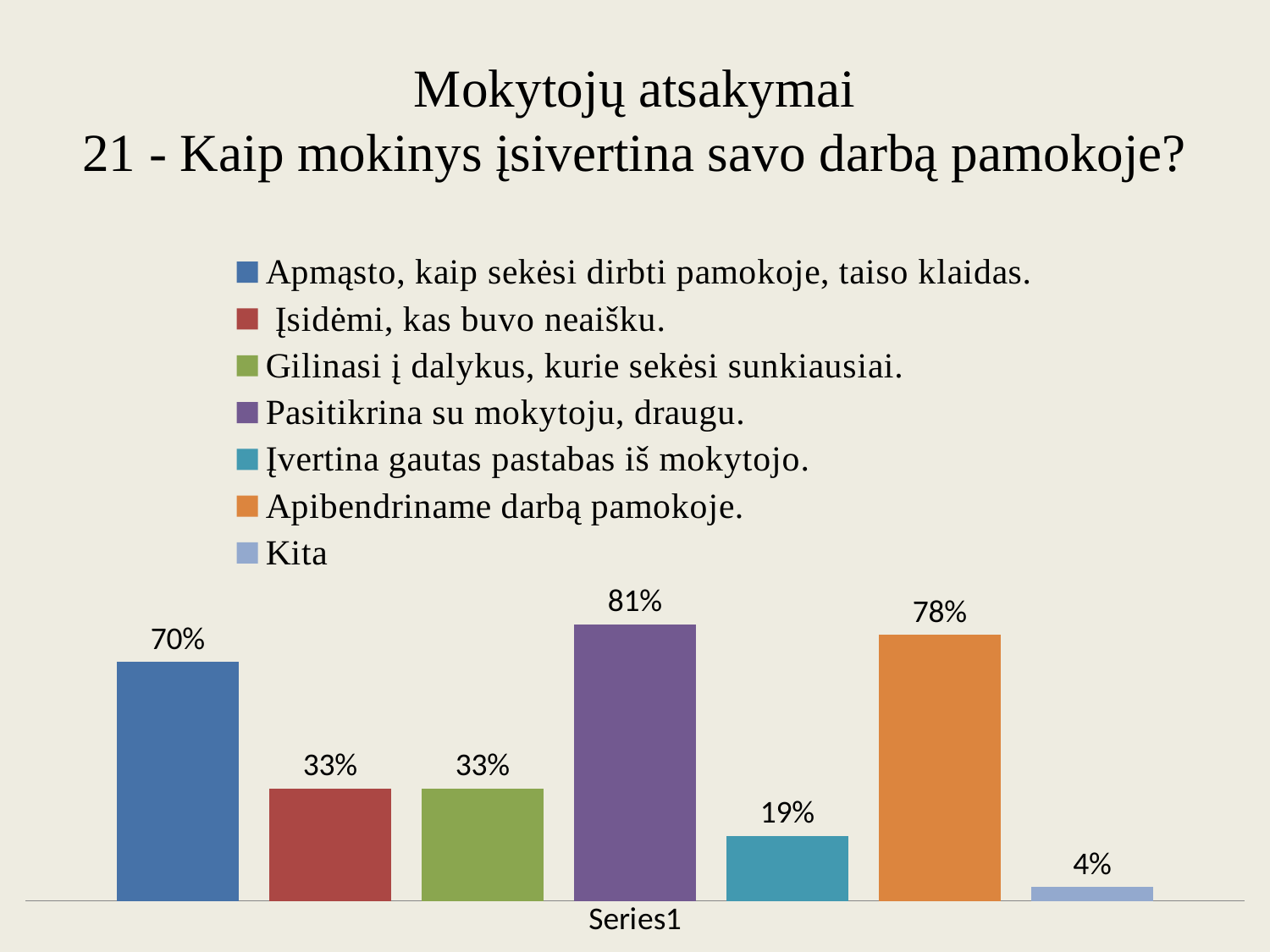
Which is larger, the value for "Apibendriname darbą pamokoje." or the value for "Apmąsto, kaip sekėsi dirbti pamokoje, taiso klaidas."? Apibendriname darbą pamokoje. What is the value for "Kita"? 4% Which legend entry has the highest value? Pasitikrina su mokytoju, draugu. What is the value for "Įvertina gautas pastabas iš mokytojo."? 19% How many bars are plotted in the chart? 7 What is the difference between the values for "Apmąsto, kaip sekėsi dirbti pamokoje, taiso klaidas." and "Įsidėmi, kas buvo neaišku."? 37% What is the difference between the values for "Pasitikrina su mokytoju, draugu." and "Apibendriname darbą pamokoje."? 3% What is the value for "Apmąsto, kaip sekėsi dirbti pamokoje, taiso klaidas."? 70% What is the value for "Pasitikrina su mokytoju, draugu."? 81% Which legend entry has the lowest value? Kita What kind of chart is shown on the slide? bar chart How many entries does the legend list? 7